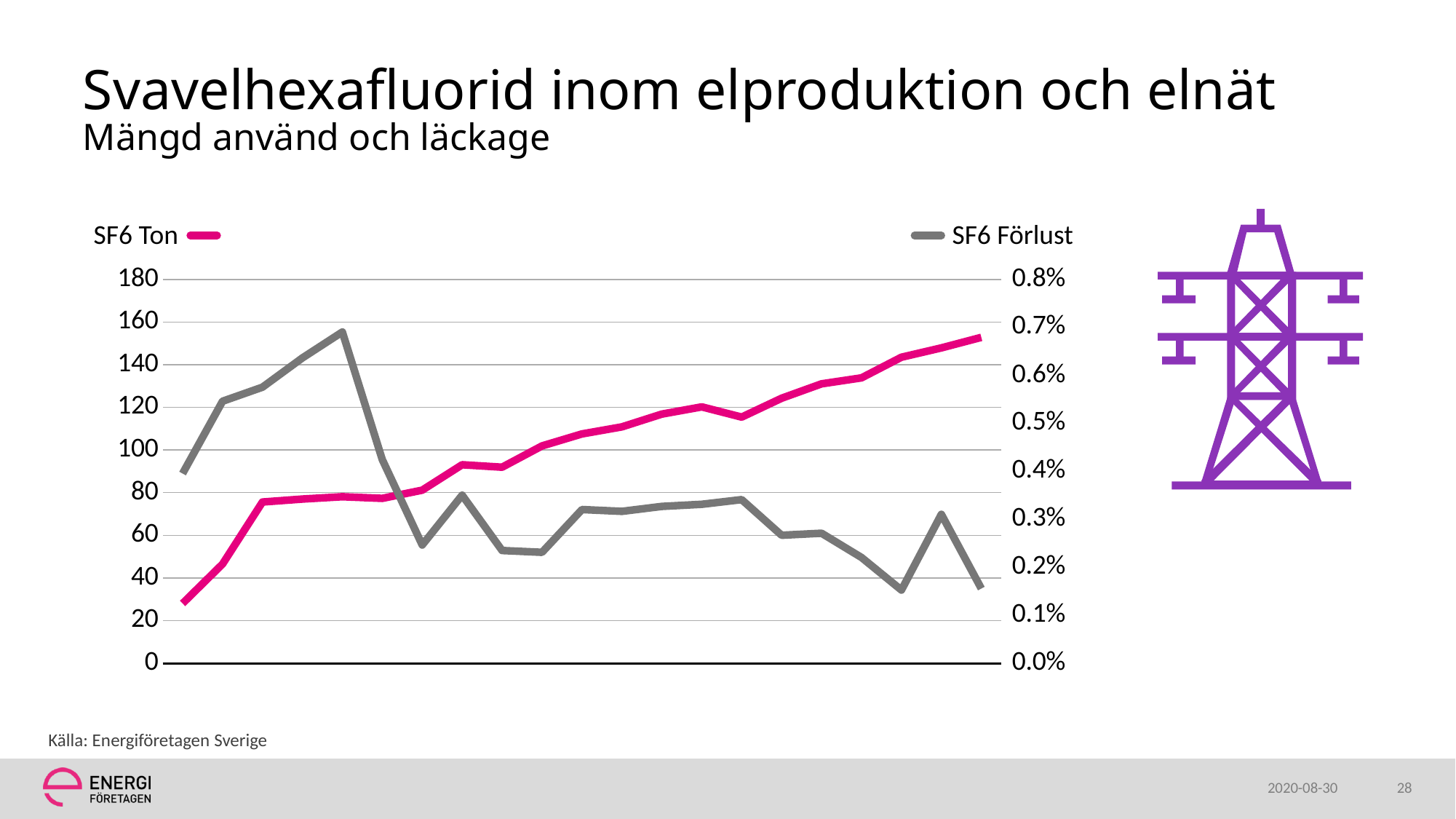
Is the highest value of the SF6 Ton line greater or less than 160? less Does the SF6 Förlust line generally rise or fall from its peak near the left to the right end of the chart? fall Is the lowest value of the SF6 Förlust line greater or less than 0.2%? less What colour is the SF6 Ton line? pink Is the highest value of the SF6 Förlust line greater or less than 0.6%? greater How many series does the chart's legend list? 2 Does the SF6 Ton line generally rise or fall along the x axis? rise What kind of chart is shown on the slide? line chart Which two series are shown in the chart's legend? SF6 Ton and SF6 Förlust